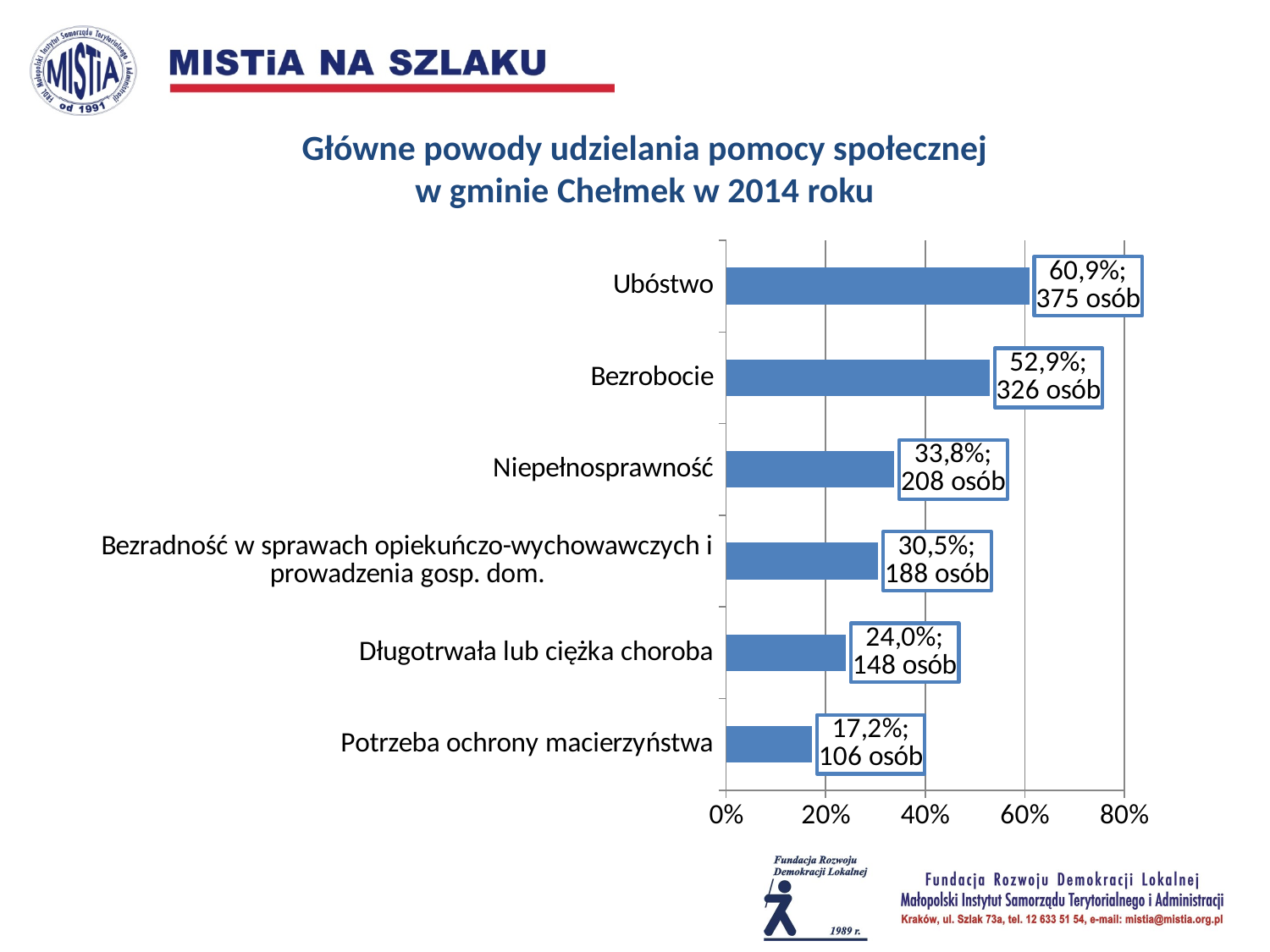
What is the title of the chart? Główne powody udzielania pomocy społecznej w gminie Chełmek w 2014 roku What percentage is shown for Ubóstwo? 60,9% How many people (osób) are shown for Potrzeba ochrony macierzyństwa? 106 osób What percentage is shown for Niepełnosprawność? 33,8% What is the difference in number of people between Ubóstwo and Bezrobocie? 49 osób Which category has the lowest value? Potrzeba ochrony macierzyństwa How many people (osób) are shown for Bezrobocie? 326 osób How many categories are shown in the chart? 6 What kind of chart is shown on the slide? bar chart Which is larger, the value for Niepełnosprawność or the value for Długotrwała lub ciężka choroba? Niepełnosprawność Which category has the highest value? Ubóstwo Is the value for Bezrobocie greater or less than 40%? greater